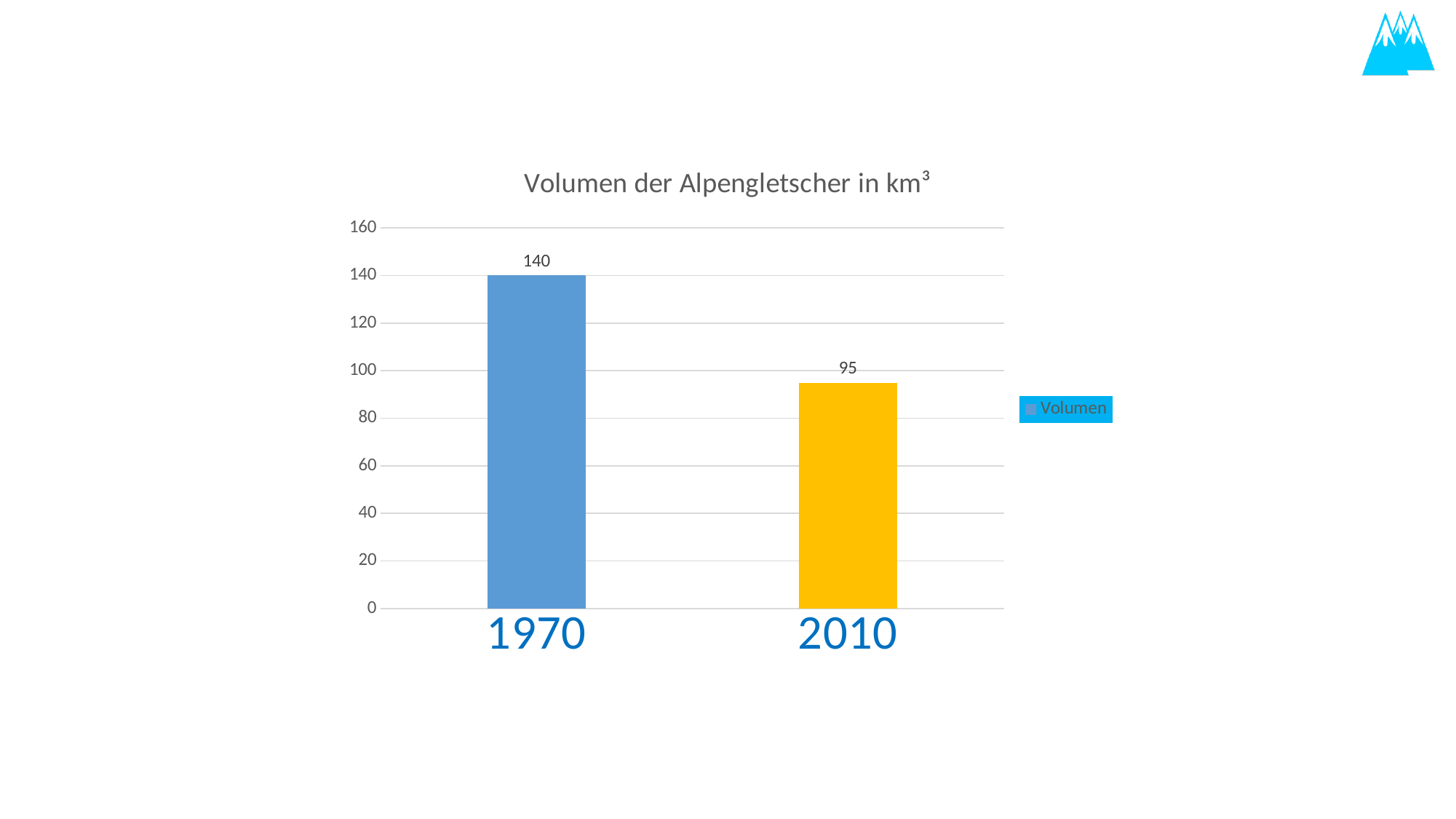
Is the value for 1970 greater or less than 120? greater Which is larger, the value for 1970 or the value for 2010? 1970 What is the difference between the values for 1970 and 2010? 45 Is the value for 2010 greater or less than 100? less How many categories are shown on the x axis? 2 How many series does the legend list? 1 What is the value for 1970? 140 What is the value for 2010? 95 Which year has the lowest value? 2010 What is the title of the chart? Volumen der Alpengletscher in km³ Which year has the highest value? 1970 What kind of chart is shown? bar chart